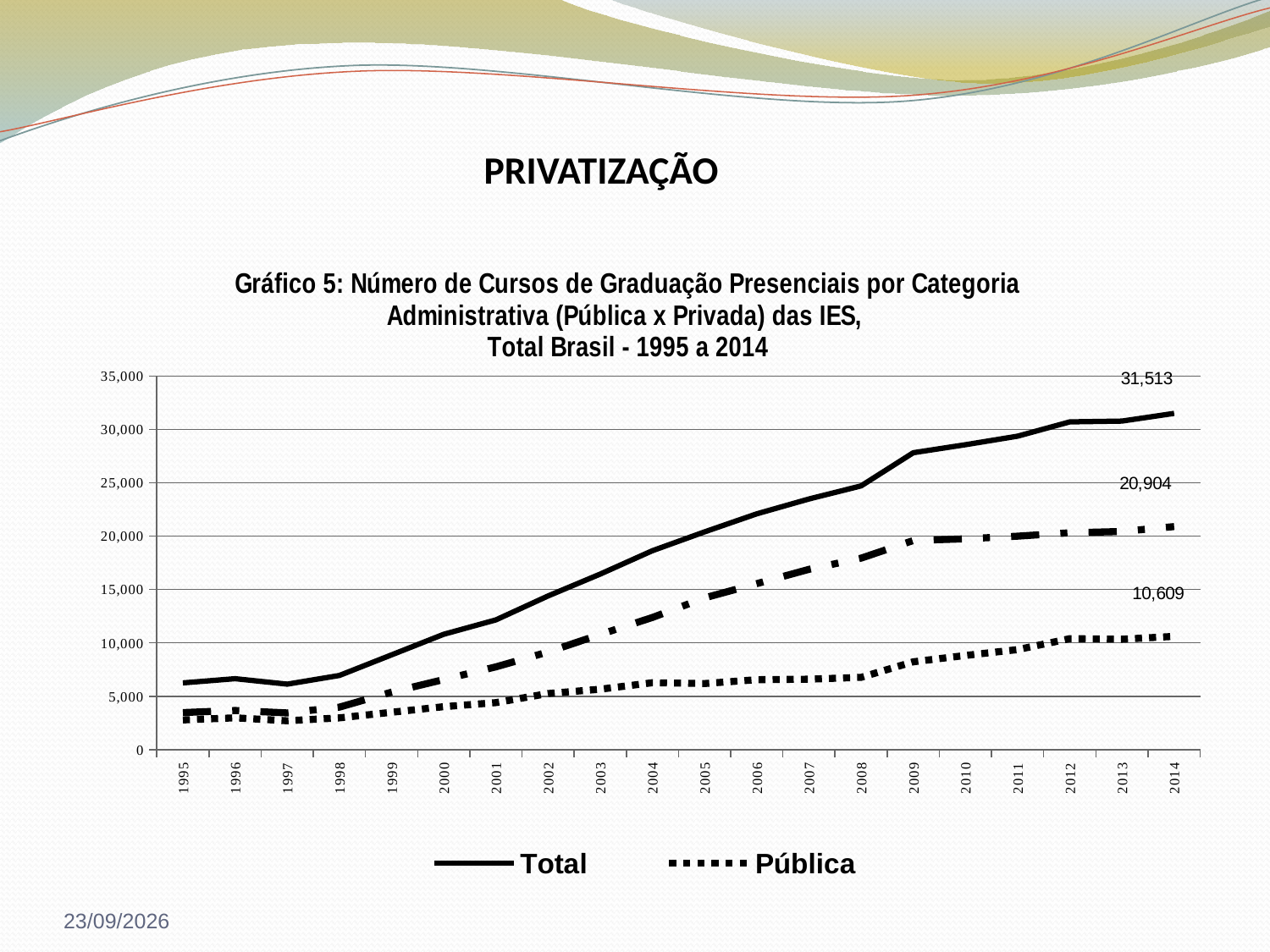
Which series has the larger value in 2014, Total or Pública? Total What kind of chart is shown on the slide? line chart Is the value of the Pública series in 2005 greater or less than 10,000? less Is the value of the Total series in 1995 greater or less than 10,000? less What value is labelled at 2014 on the dash-dot line between the Total and Pública lines? 20,904 What is the value of the Pública series in 2014? 10,609 Does the Total series generally rise or fall from 1995 to 2014? rise How many series does the legend list? 2 What is the value of the Total series in 2014? 31,513 What is the difference between the Total and Pública values in 2014? 20,904 Is the value of the Total series in 2009 greater or less than 25,000? greater How many years are shown on the x axis? 20